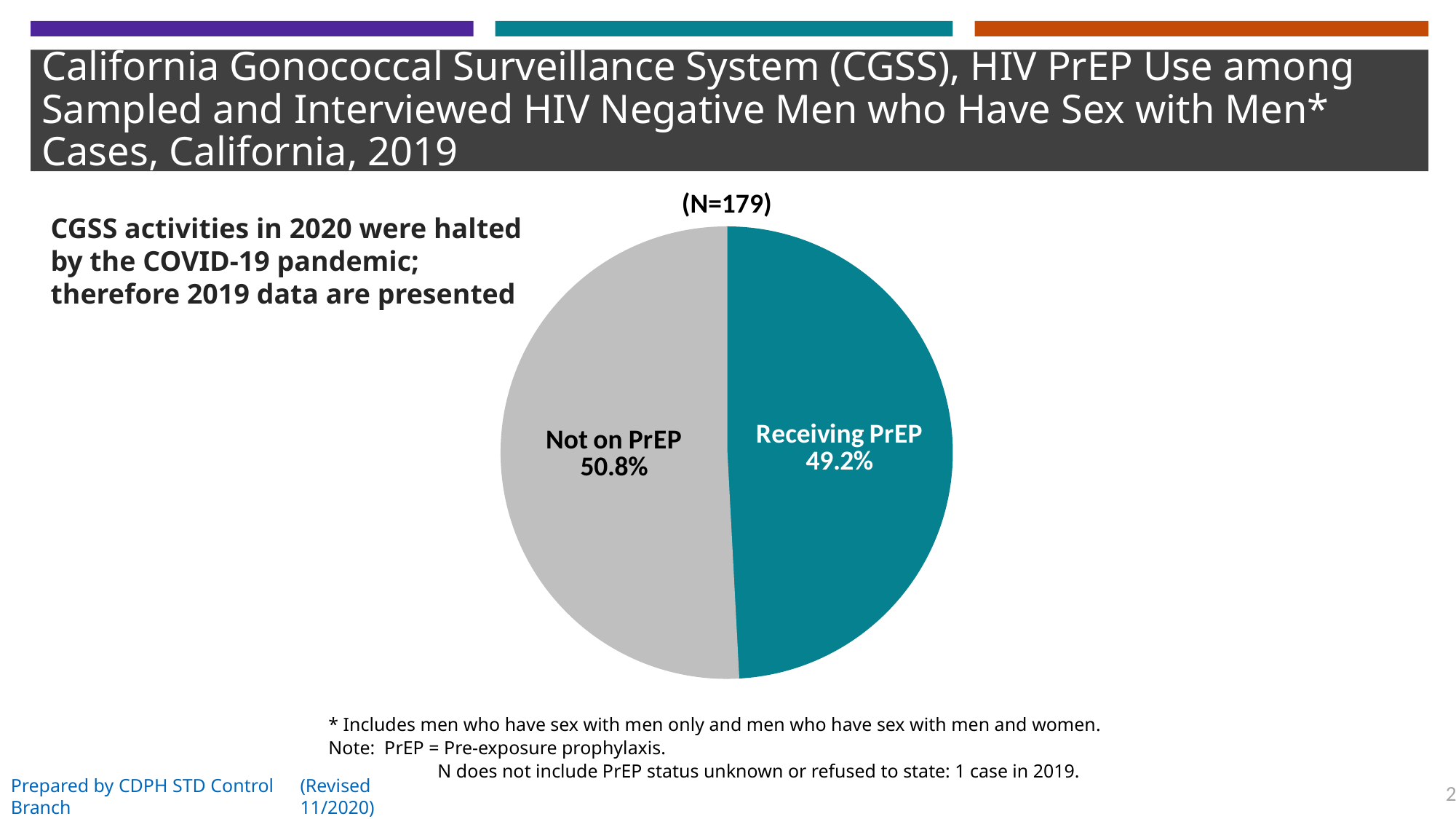
Which slice of the pie is smaller? Receiving PrEP What colour is the Receiving PrEP slice? teal Is the share for Receiving PrEP greater or less than 50%? less How many slices does the pie chart have? 2 What share of the pie does the Not on PrEP slice represent? 50.8% What is the difference in percentage points between Not on PrEP and Receiving PrEP? 1.6 Which slice of the pie is larger, Not on PrEP or Receiving PrEP? Not on PrEP What percentage of cases were receiving PrEP? 49.2% What kind of chart is shown on the slide? pie chart What percentage of cases were not on PrEP? 50.8% What is the total N shown above the pie chart? N=179